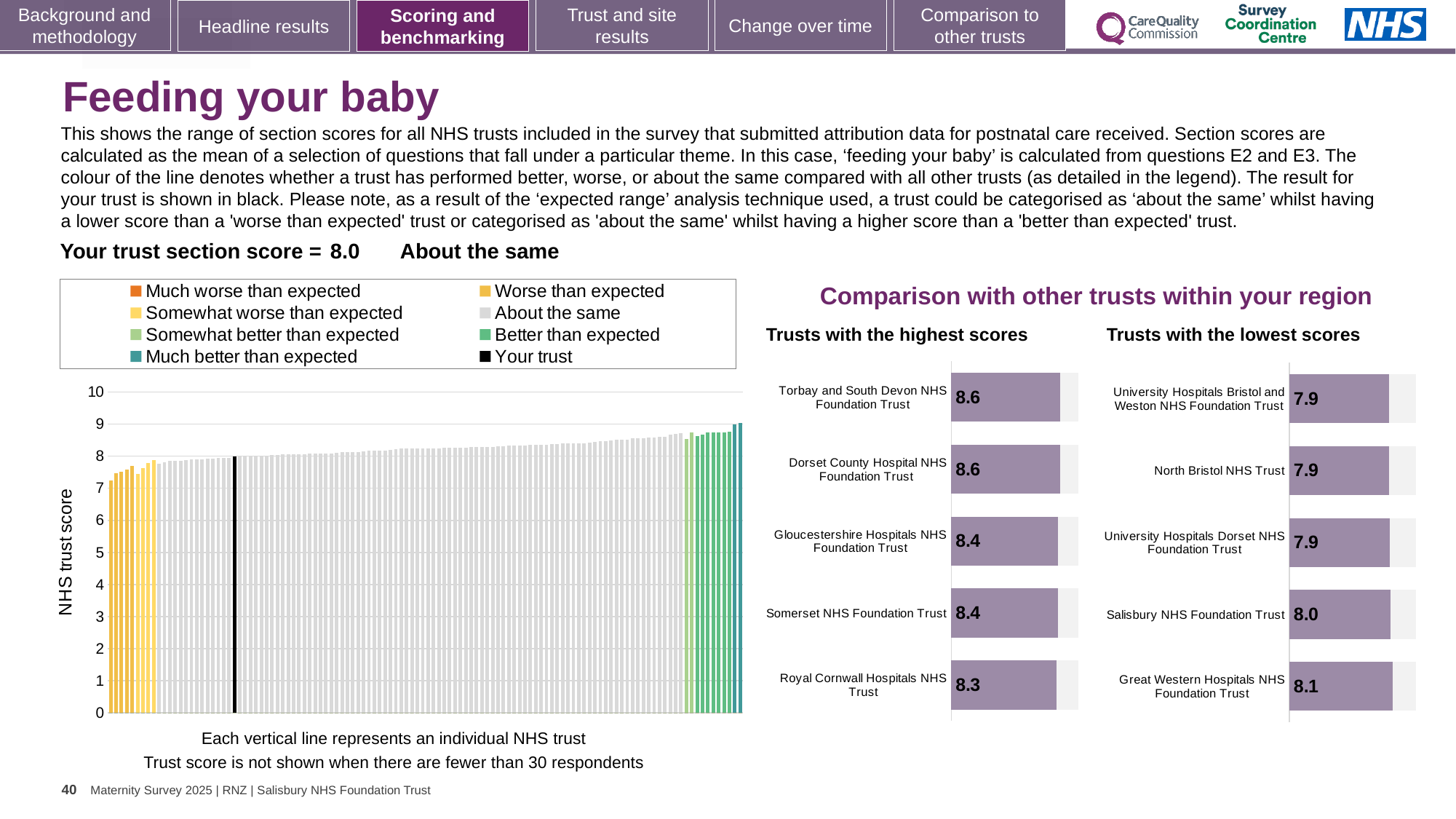
In the 'Trusts with the lowest scores' chart, what is the difference between the scores of Great Western Hospitals NHS Foundation Trust and Salisbury NHS Foundation Trust? 0.1 What kind of chart is the main chart showing NHS trust scores? Bar chart How many entries does the legend of the main NHS trust score chart list? 8 In the 'Trusts with the lowest scores' chart, what is the score for Salisbury NHS Foundation Trust? 8.0 How many trusts are shown in the 'Trusts with the lowest scores' chart? 5 In the 'Trusts with the lowest scores' chart, which has the larger score: Great Western Hospitals NHS Foundation Trust or North Bristol NHS Trust? Great Western Hospitals NHS Foundation Trust In the 'Trusts with the highest scores' chart, what is the score for Royal Cornwall Hospitals NHS Trust? 8.3 In the main NHS trust score chart, do the values rise or fall from left to right? Rise In the 'Trusts with the highest scores' chart, what is the difference between the scores of Torbay and South Devon NHS Foundation Trust and Royal Cornwall Hospitals NHS Trust? 0.3 In the 'Trusts with the lowest scores' chart, which trust has the highest score? Great Western Hospitals NHS Foundation Trust In the 'Trusts with the highest scores' chart, what is the score for Torbay and South Devon NHS Foundation Trust? 8.6 In the 'Trusts with the highest scores' chart, which trust has the lowest score? Royal Cornwall Hospitals NHS Trust